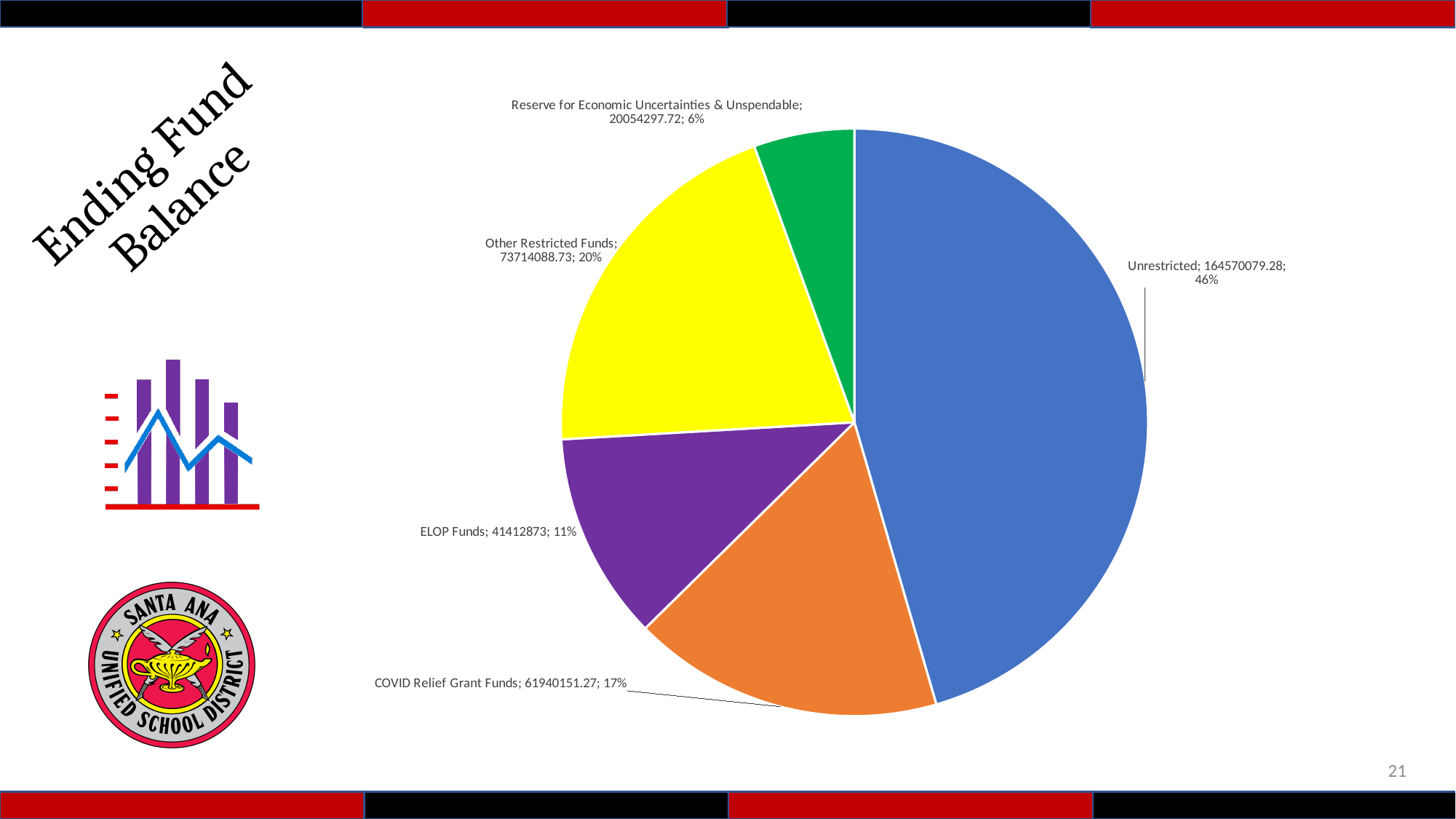
What is the value for ELOP Funds? 41412873 Which is larger, Other Restricted Funds or COVID Relief Grant Funds? Other Restricted Funds What is the value for Unrestricted? 164570079.28 What share of the pie does Reserve for Economic Uncertainties & Unspendable represent? 6% What is the title of the slide containing the pie chart? Ending Fund Balance What kind of chart is shown on the slide? pie chart Which category has the largest slice of the pie? Unrestricted What is the value for COVID Relief Grant Funds? 61940151.27 What is the difference in percentage share between Unrestricted and Other Restricted Funds? 26% What share of the pie does Other Restricted Funds represent? 20% How many slices does the pie chart have? 5 Which category has the smallest slice of the pie? Reserve for Economic Uncertainties & Unspendable